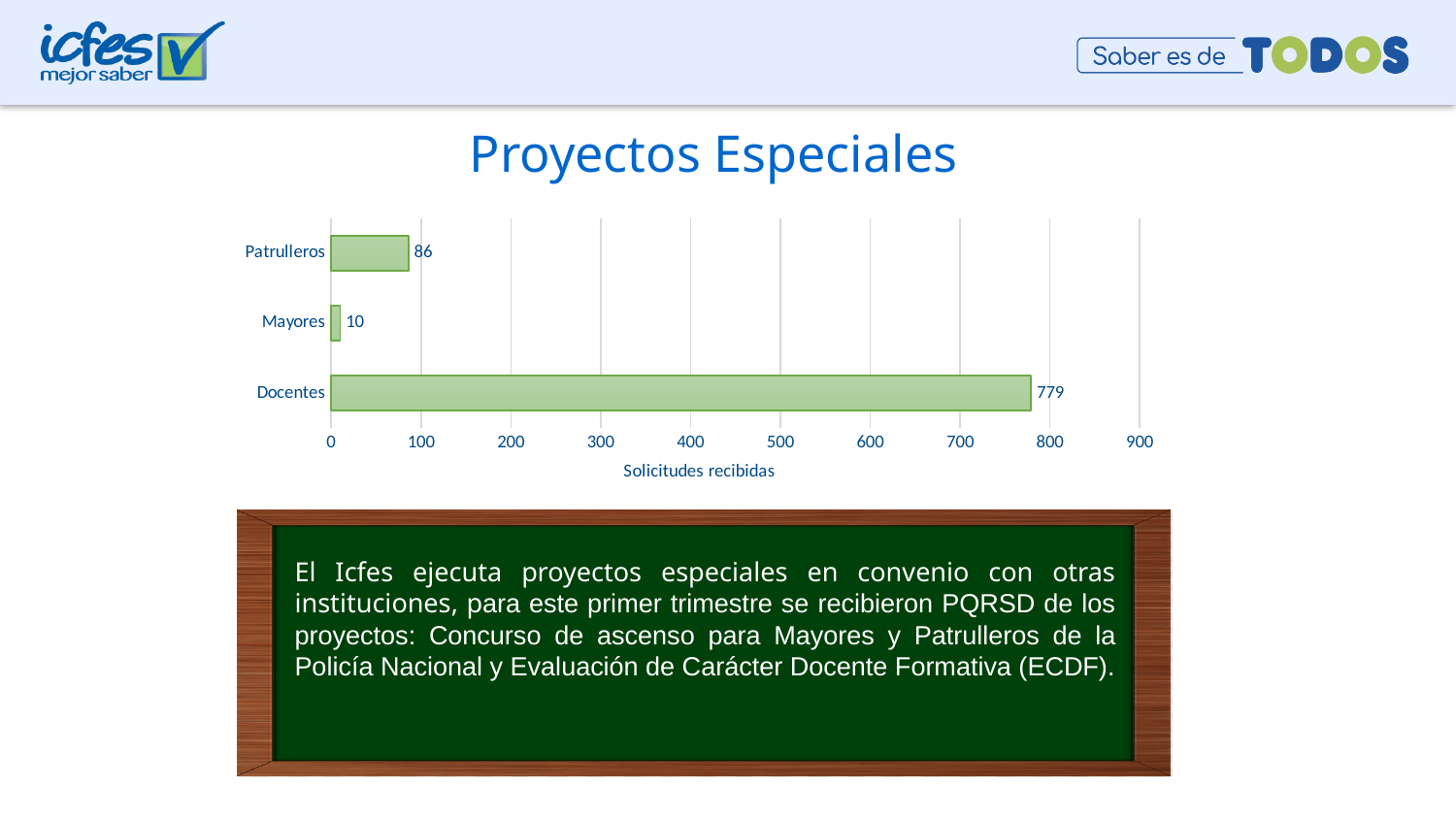
What is the label of the horizontal axis? Solicitudes recibidas What is the value for Mayores? 10 What is the value for Docentes? 779 What is the value for Patrulleros? 86 What kind of chart is shown on the slide? bar chart What is the difference between the values for Docentes and Patrulleros? 693 Which category has the lowest value? Mayores How many categories are shown in the chart? 3 What is the difference between the values for Patrulleros and Mayores? 76 Which category has the highest value? Docentes Is the value for Docentes greater or less than 700? greater Which is larger, the value for Patrulleros or the value for Mayores? Patrulleros